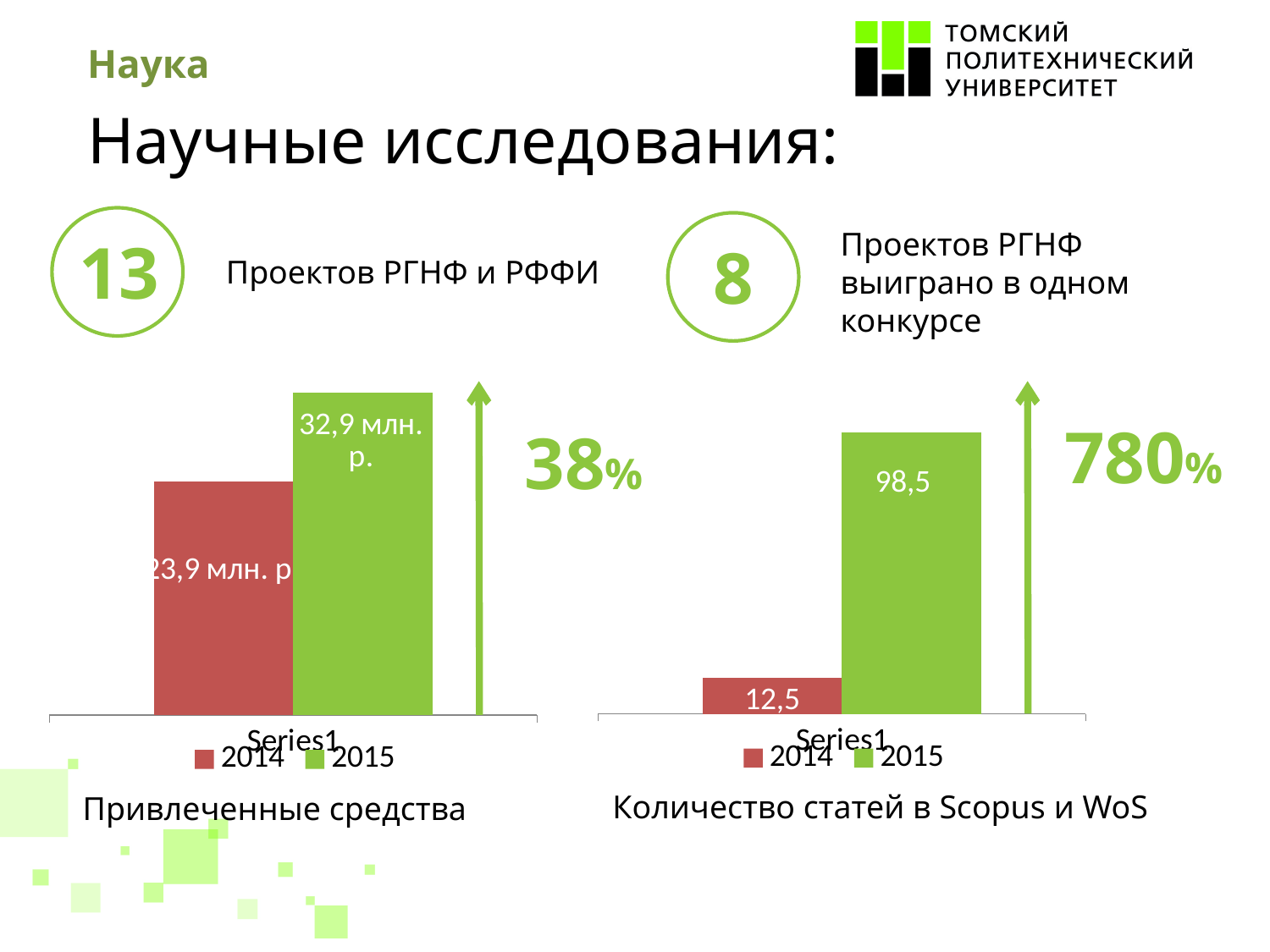
What kind of chart is the chart titled 'Привлеченные средства'? bar chart How many series does the legend of the chart titled 'Количество статей в Scopus и WoS' list? 2 In the chart titled 'Количество статей в Scopus и WoS', what colour is the bar for 2014? red In the chart titled 'Количество статей в Scopus и WoS', which year has the higher value? 2015 In the chart titled 'Количество статей в Scopus и WoS', what is the difference between the 2015 and 2014 values? 86 In the chart titled 'Количество статей в Scopus и WoS', what is the value for 2015? 98,5 In the chart titled 'Привлеченные средства', which year has the lower value? 2014 In the chart titled 'Количество статей в Scopus и WoS', what is the value for 2014? 12,5 In the chart titled 'Привлеченные средства', what is the value for 2015? 32,9 млн. р. In the chart titled 'Привлеченные средства', what is the value for 2014? 23,9 млн. р. In the chart titled 'Привлеченные средства', by how much does the 2015 value exceed the 2014 value? 9 млн. р. In the chart titled 'Привлеченные средства', is the value for 2015 larger or smaller than the value for 2014? larger